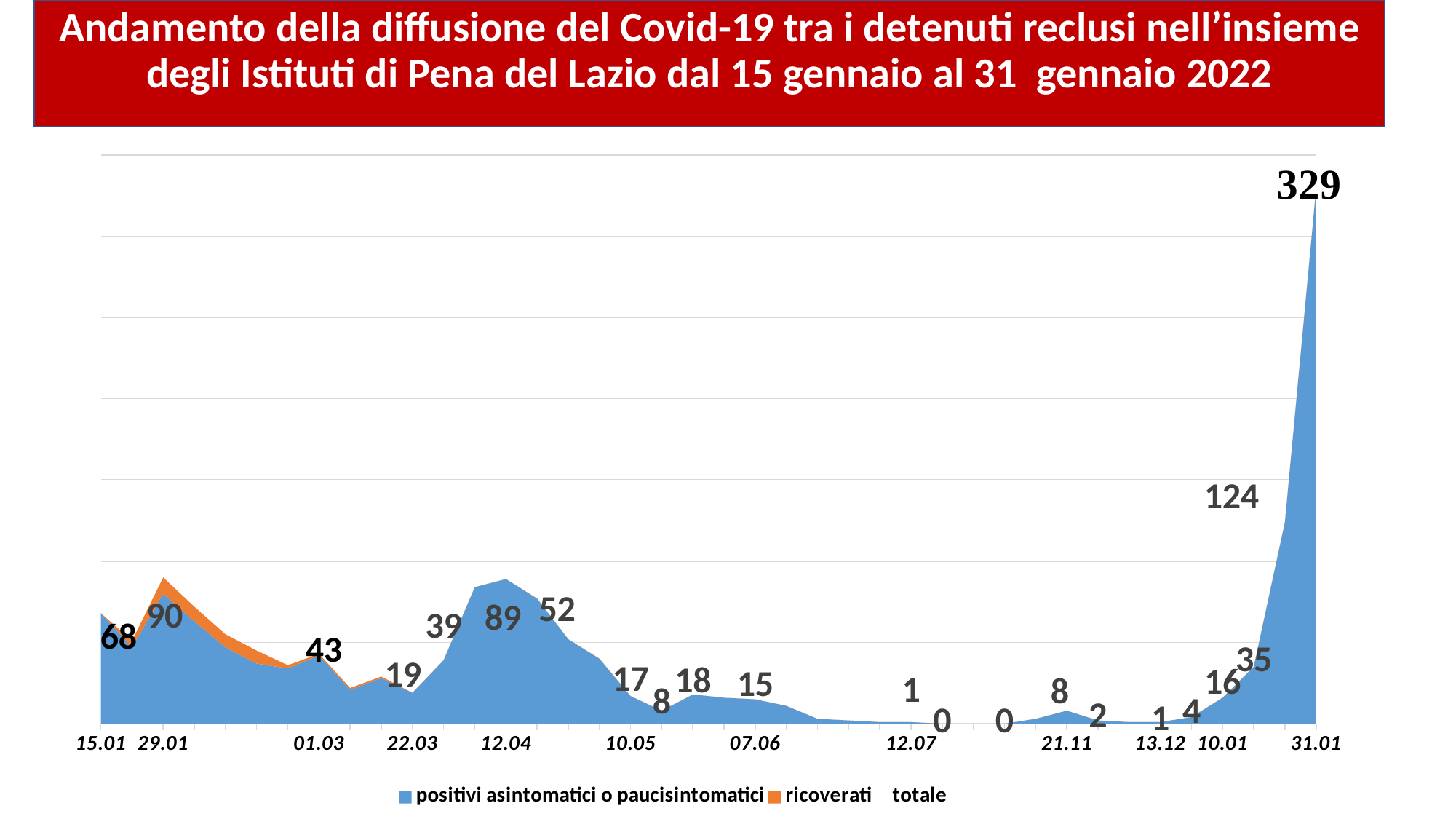
What is the difference between the value for 31.01 (329) and the preceding labelled value of 124? 205 What is the value shown for 15.01? 68 Which is larger, the value labelled 89 or the value labelled 52? 89 What is the difference between the values for 29.01 and 15.01? 22 How many series does the legend list? 3 How many date labels are shown on the x axis? 12 What is the value shown for 01.03? 43 Which date has the highest value on the chart? 31.01 What kind of chart is shown on the slide? Area chart What is the value shown for 31.01? 329 Do the values rise or fall between 10.01 and 31.01? Rise What is the value shown for 29.01? 90